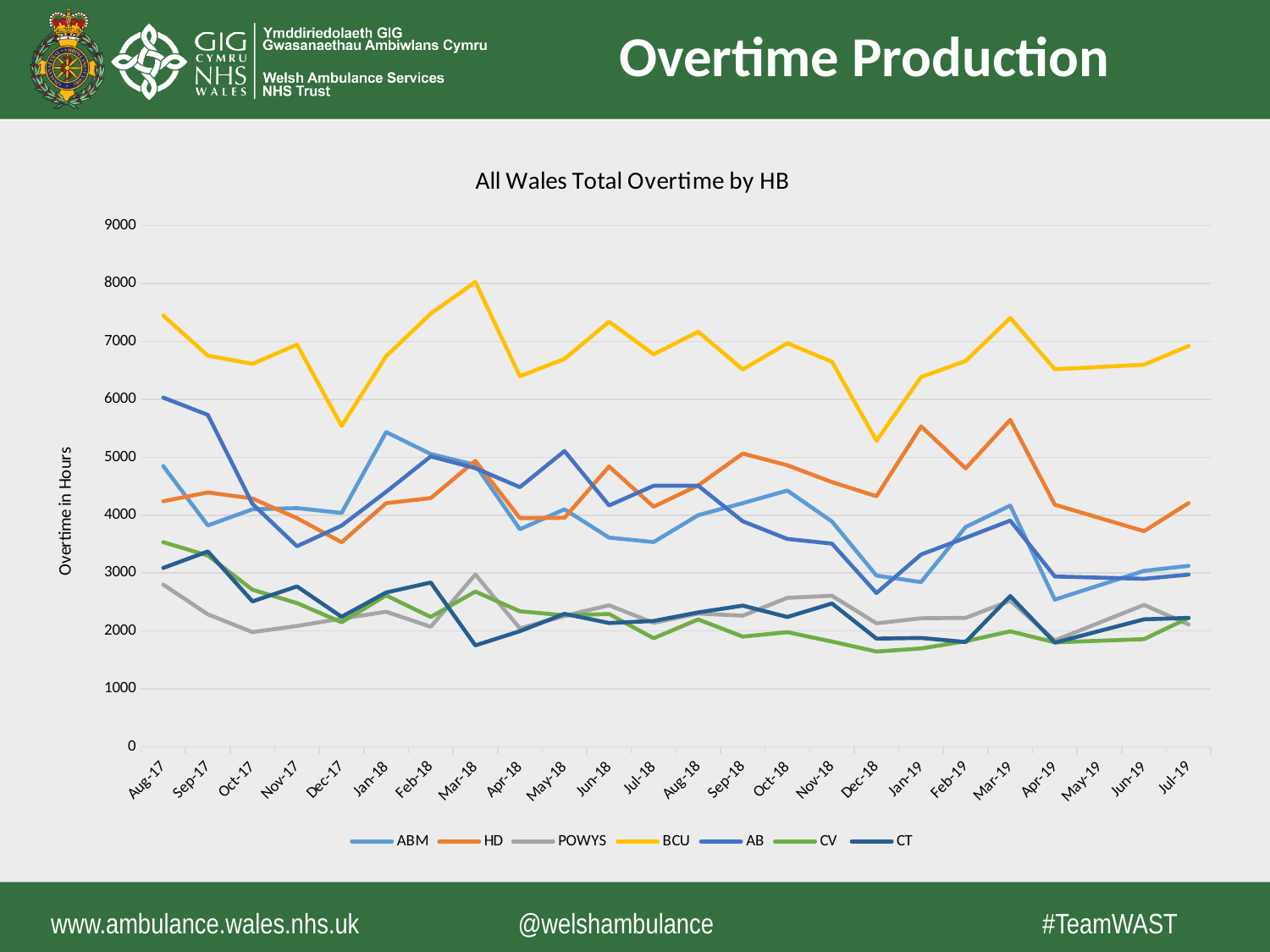
Which series has the highest value in Aug-17? BCU What is the label on the vertical axis? Overtime in Hours Which series has the lowest value in Dec-18? CV Is the value for AB in Nov-17 greater or less than 4000? less How many months are shown along the x axis? 24 What kind of chart is shown on the slide? Line chart How many series does the legend list? 7 What is the title of the chart? All Wales Total Overtime by HB Does the AB series rise or fall from Aug-17 to Nov-17? Fall In Jul-19, which is larger, the value for BCU or the value for HD? BCU Is the value for CT in Mar-18 greater or less than 2000? less Is the value for BCU in Aug-17 greater or less than 7000? greater